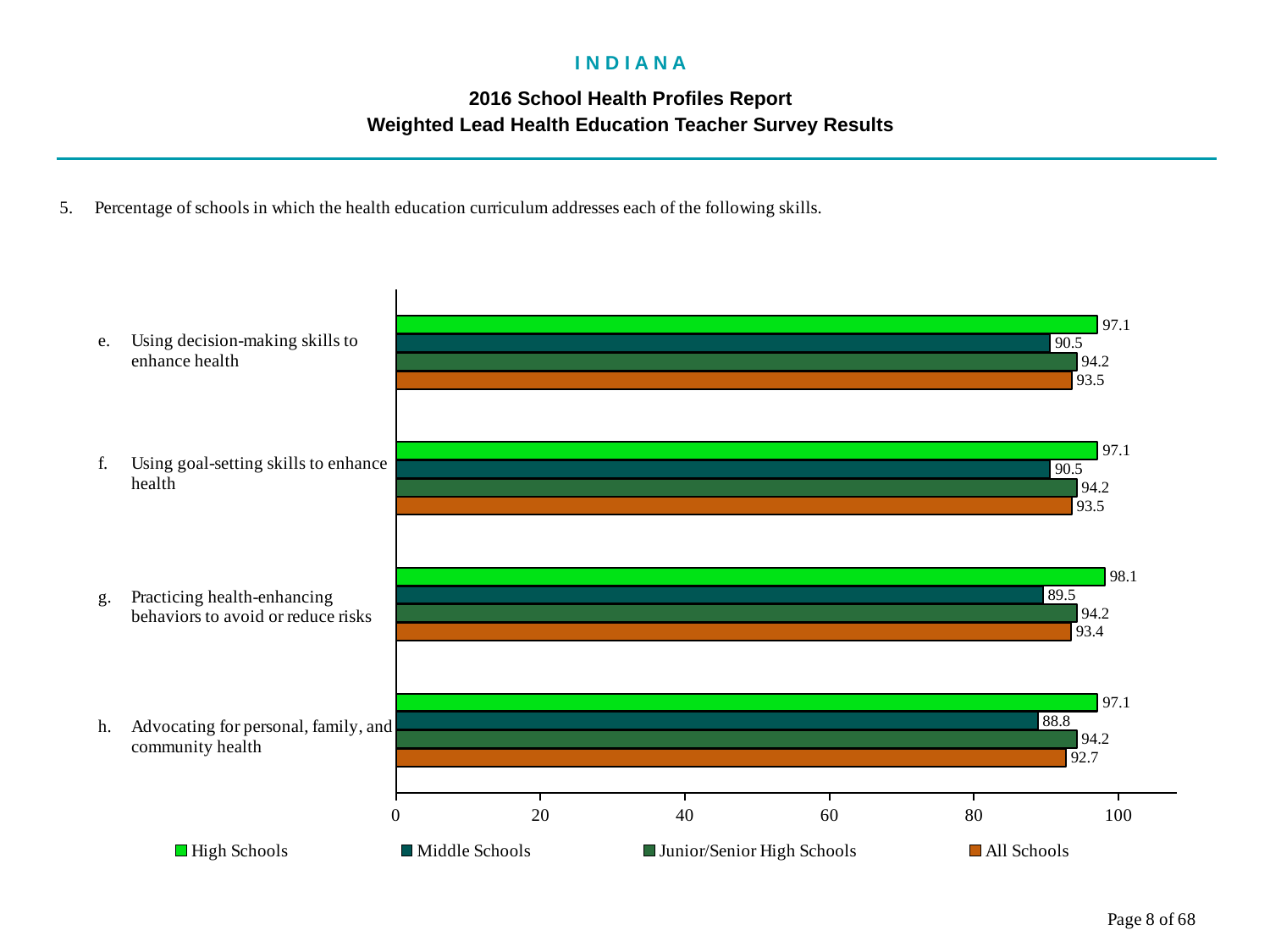
What kind of chart is shown on the slide? Bar chart Which series is shown in orange in the legend? All Schools How many skill categories are shown in the chart? 4 What is the All Schools value for 'Using decision-making skills to enhance health'? 93.5 How many series does the legend list? 4 What is the Junior/Senior High Schools value for 'Using goal-setting skills to enhance health'? 94.2 Which category has the highest High Schools value? Practicing health-enhancing behaviors to avoid or reduce risks For 'Advocating for personal, family, and community health', which is larger: the Junior/Senior High Schools value or the All Schools value? Junior/Senior High Schools What is the difference between the High Schools and Middle Schools values for 'Practicing health-enhancing behaviors to avoid or reduce risks'? 8.6 Which category has the lowest Middle Schools value? Advocating for personal, family, and community health What is the Middle Schools value for 'Advocating for personal, family, and community health'? 88.8 What is the High Schools value for 'Practicing health-enhancing behaviors to avoid or reduce risks'? 98.1